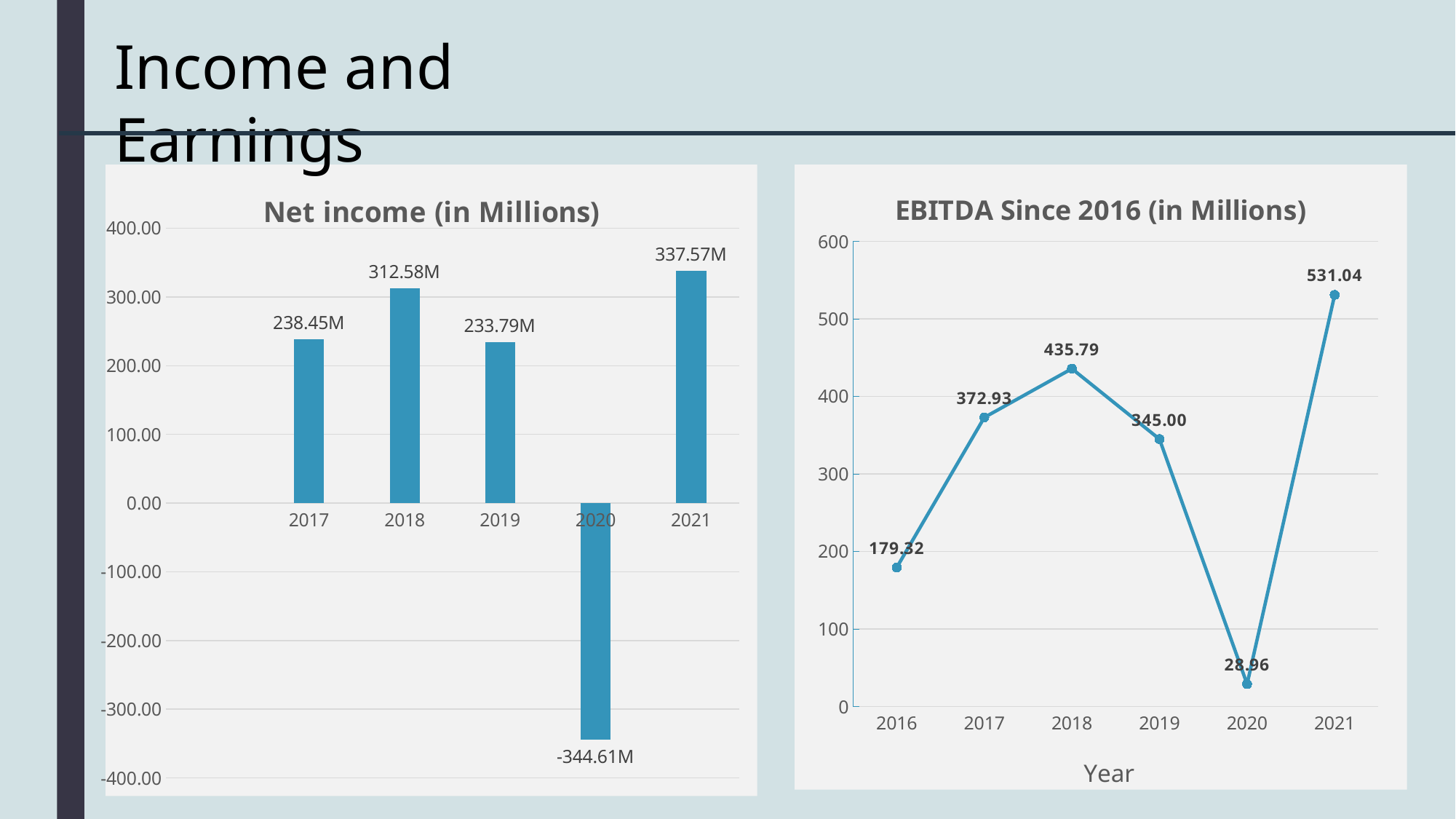
In the Net income (in Millions) chart, what is the value for 2018? 312.58M In the EBITDA Since 2016 (in Millions) chart, which is larger, the value for 2017 or the value for 2018? 2018 In the EBITDA Since 2016 (in Millions) chart, which year has the lowest EBITDA? 2020 In the Net income (in Millions) chart, which year has the lowest net income? 2020 What kind of chart is the EBITDA Since 2016 (in Millions) chart? Line chart In the EBITDA Since 2016 (in Millions) chart, what is the value for 2019? 345.00 In the EBITDA Since 2016 (in Millions) chart, what is the difference between the 2021 and 2020 values? 502.08 In the Net income (in Millions) chart, which year has the highest net income? 2021 In the Net income (in Millions) chart, what is the value for 2020? -344.61M In the Net income (in Millions) chart, what is the difference between the 2021 and 2018 values? 24.99M In the Net income (in Millions) chart, how many years are shown? 5 What kind of chart is the Net income (in Millions) chart? Bar chart